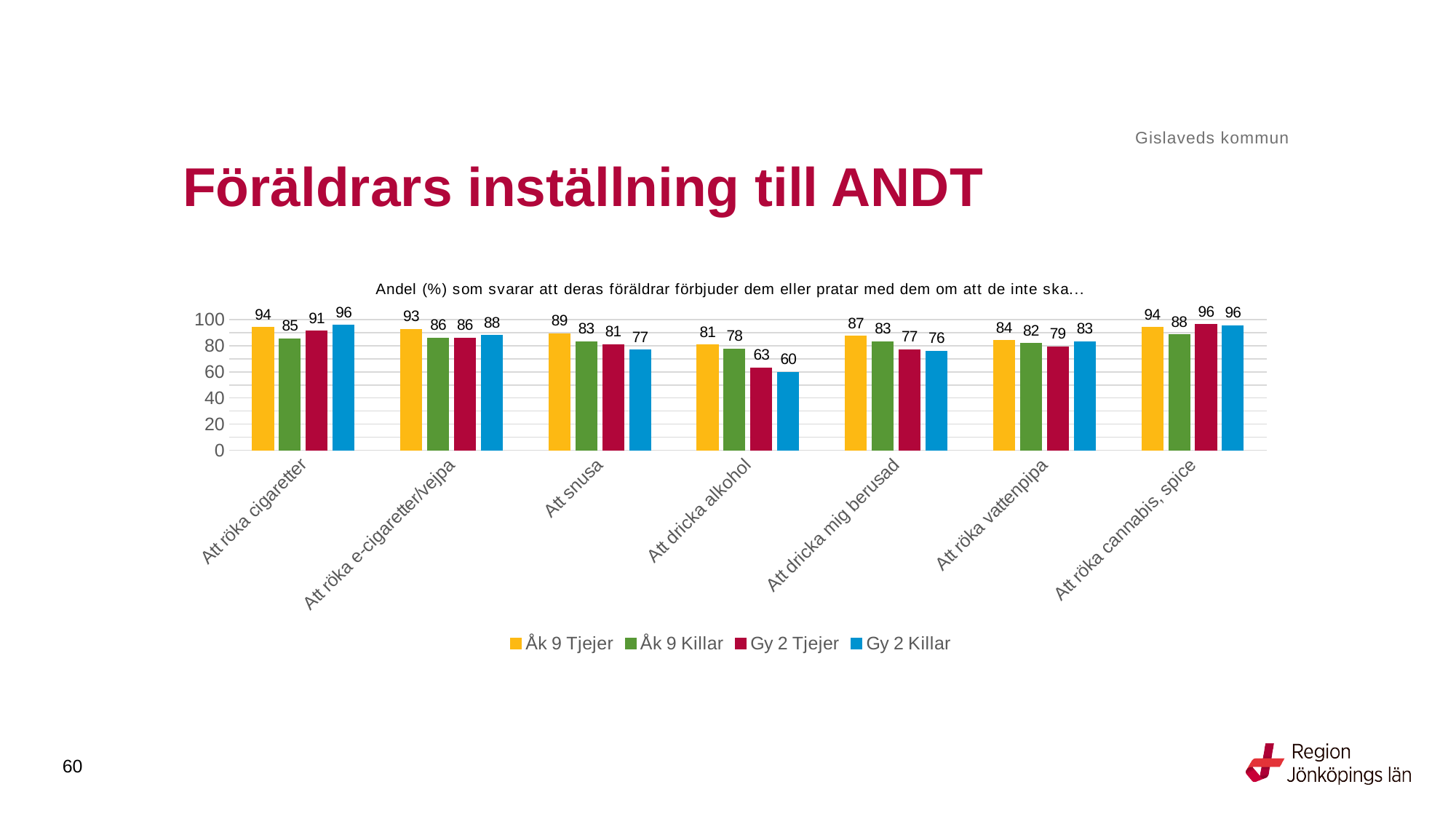
Which category has the highest value for Åk 9 Killar? Att röka cannabis, spice How many series does the legend list? 4 What is the value for Åk 9 Killar for 'Att röka vattenpipa'? 82 What is the value for Åk 9 Tjejer for 'Att röka cigaretter'? 94 How many categories are shown on the x axis? 7 Which series is shown in blue in the legend? Gy 2 Killar What is the difference between the Åk 9 Tjejer and Gy 2 Killar values for 'Att dricka alkohol'? 21 Which category has the lowest value for Gy 2 Tjejer? Att dricka alkohol Which is larger for 'Att snusa': the Åk 9 Tjejer value or the Gy 2 Killar value? Åk 9 Tjejer What is the value for Gy 2 Killar for 'Att dricka alkohol'? 60 What kind of chart is shown on the slide? Bar chart What is the value for Gy 2 Tjejer for 'Att dricka mig berusad'? 77